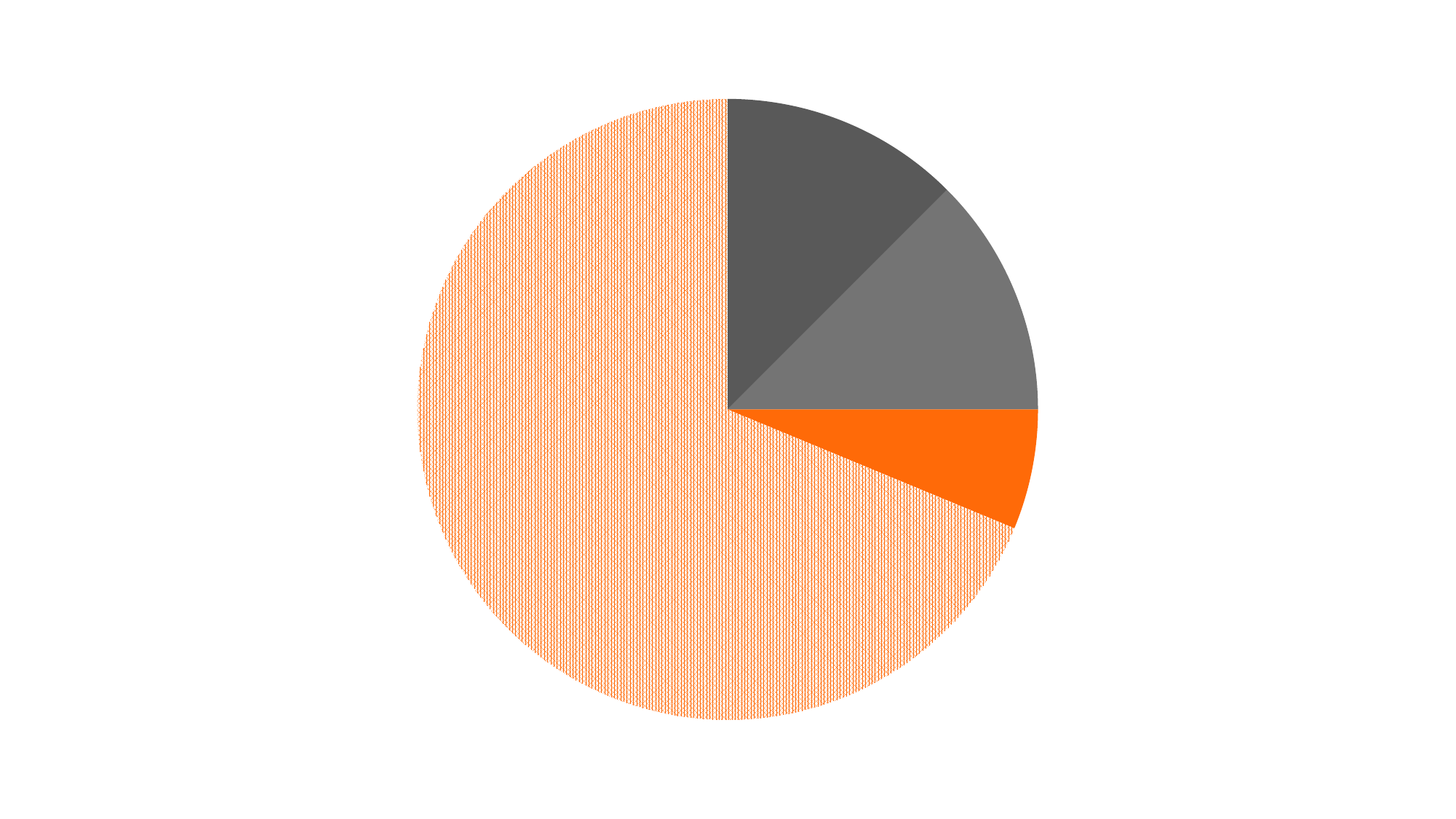
Which is larger, the medium gray slice or the solid orange slice? the medium gray slice Which slice of the pie chart is the smallest? the solid orange slice Does the patterned orange slice take up more or less than half of the pie? more Which is larger, the patterned orange slice or the dark gray slice? the patterned orange slice Which slice of the pie chart is the largest? the patterned orange slice Does the pie chart have a legend? No How many slices does the pie chart have? 4 Does the pie chart show data labels on its slices? No What kind of chart is shown on the slide? pie chart